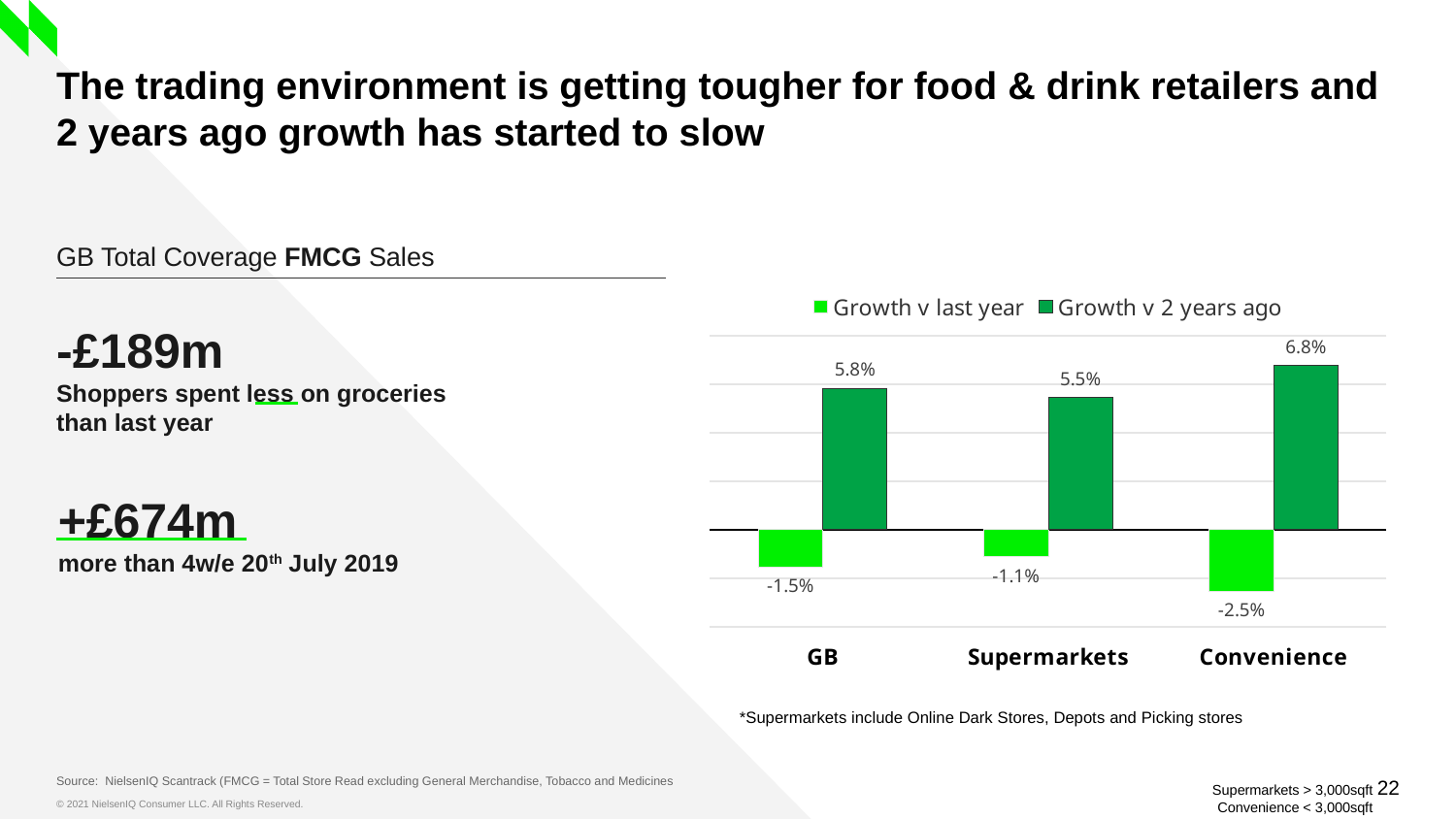
What is the value of Growth v 2 years ago for Supermarkets? 5.5% Which category has the highest Growth v 2 years ago? Convenience What type of chart is shown on the slide? Bar chart What is the value of Growth v last year for Supermarkets? -1.1% What is the value of Growth v last year for GB? -1.5% What is the difference between Growth v 2 years ago and Growth v last year for GB? 7.3 percentage points Which is larger, Growth v 2 years ago for GB or for Supermarkets? GB What is the value of Growth v 2 years ago for Convenience? 6.8% How many categories are shown on the x axis of the chart? 3 Which category has the lowest Growth v last year? Convenience How many series does the chart legend list? 2 What are the two series names listed in the chart legend? Growth v last year; Growth v 2 years ago